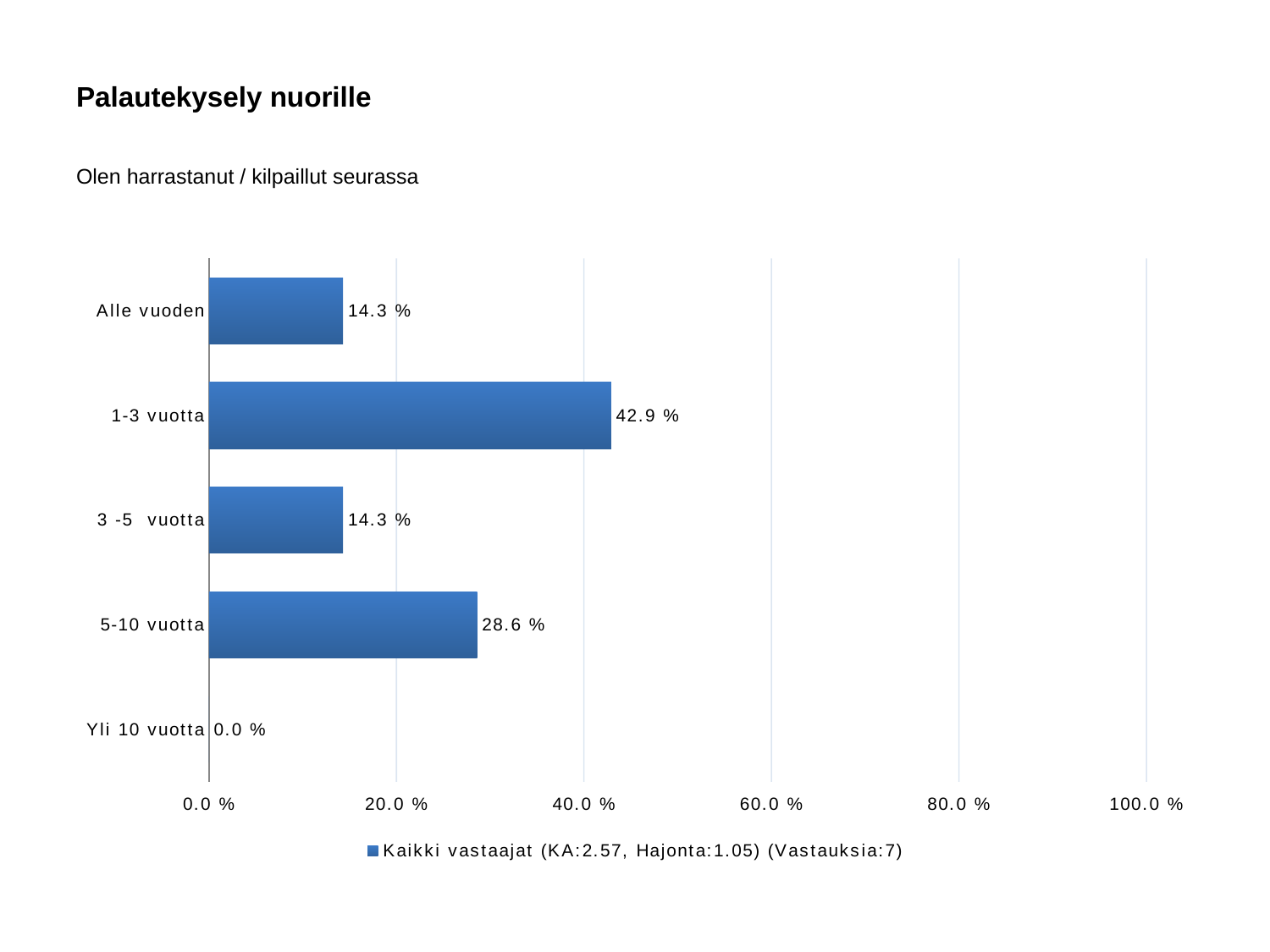
What is the value for "Alle vuoden"? 14.3 % What is the value for "1-3 vuotta"? 42.9 % What is the legend entry shown below the chart? Kaikki vastaajat (KA:2.57, Hajonta:1.05) (Vastauksia:7) Which category has the highest value? 1-3 vuotta How many categories are shown on the chart? 5 Is the value for "1-3 vuotta" greater or less than 40.0 %? greater What is the difference between the values for "1-3 vuotta" and "5-10 vuotta"? 14.3 % What is the value for "5-10 vuotta"? 28.6 % Which category has the lowest value? Yli 10 vuotta What is the value for "Yli 10 vuotta"? 0.0 % What kind of chart is shown on the slide? bar chart Which is larger, the value for "5-10 vuotta" or the value for "3 -5 vuotta"? 5-10 vuotta